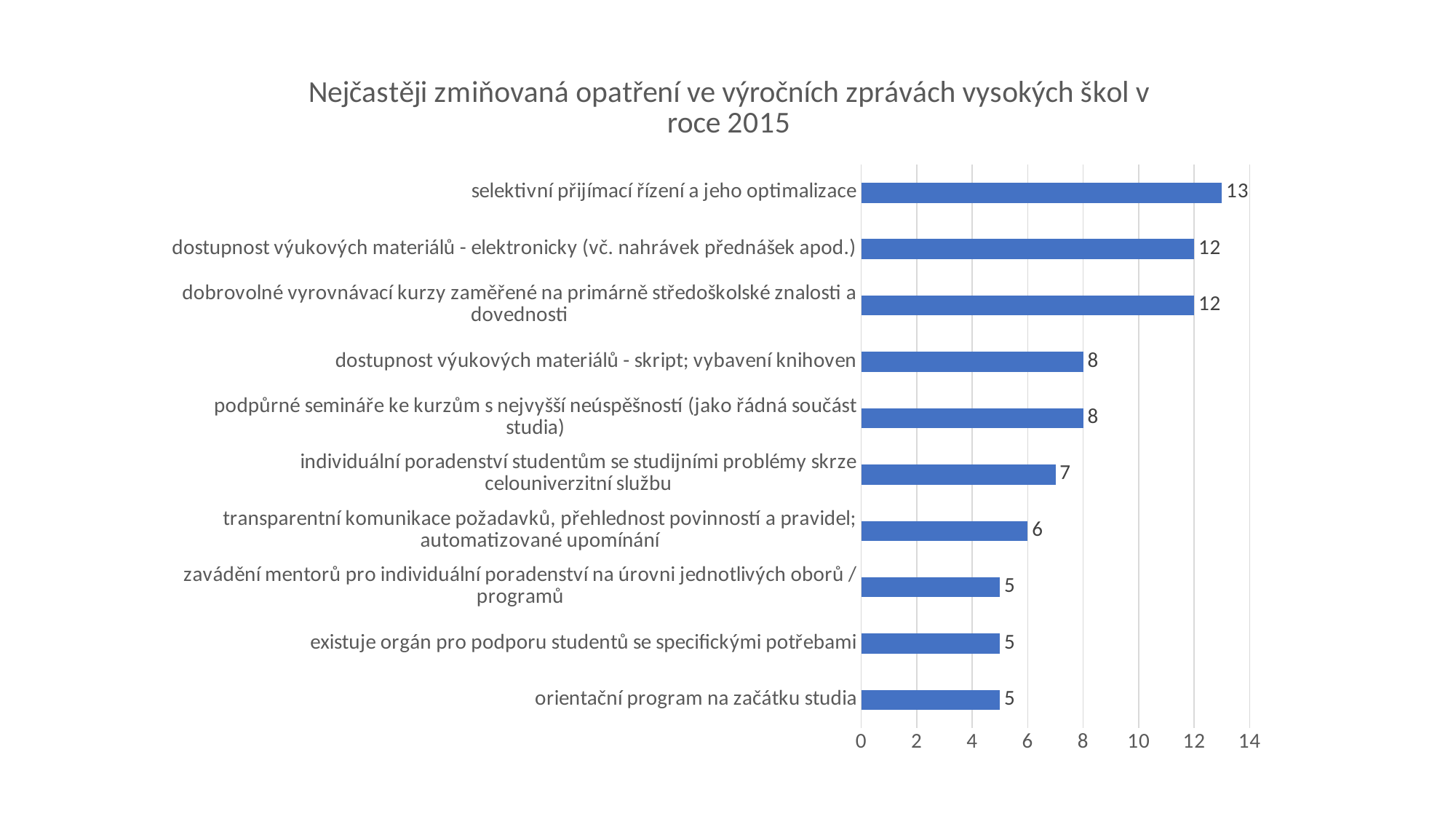
Which is larger: the value for 'dostupnost výukových materiálů - elektronicky (vč. nahrávek přednášek apod.)' or the value for 'podpůrné semináře ke kurzům s nejvyšší neúspěšností (jako řádná součást studia)'? dostupnost výukových materiálů - elektronicky (vč. nahrávek přednášek apod.) Which category has the highest value? selektivní přijímací řízení a jeho optimalizace What is the value for 'selektivní přijímací řízení a jeho optimalizace'? 13 What kind of chart is shown on the slide? bar chart What is the highest value shown on the horizontal axis? 14 What is the value for 'dostupnost výukových materiálů - skript; vybavení knihoven'? 8 What is the title of the chart? Nejčastěji zmiňovaná opatření ve výročních zprávách vysokých škol v roce 2015 What is the difference between the values for 'selektivní přijímací řízení a jeho optimalizace' and 'transparentní komunikace požadavků, přehlednost povinností a pravidel; automatizované upomínání'? 7 What is the value for 'orientační program na začátku studia'? 5 Is the value for 'zavádění mentorů pro individuální poradenství na úrovni jednotlivých oborů / programů' greater or less than 10? less How many categories are shown in the chart? 10 What is the value for 'individuální poradenství studentům se studijními problémy skrze celouniverzitní službu'? 7